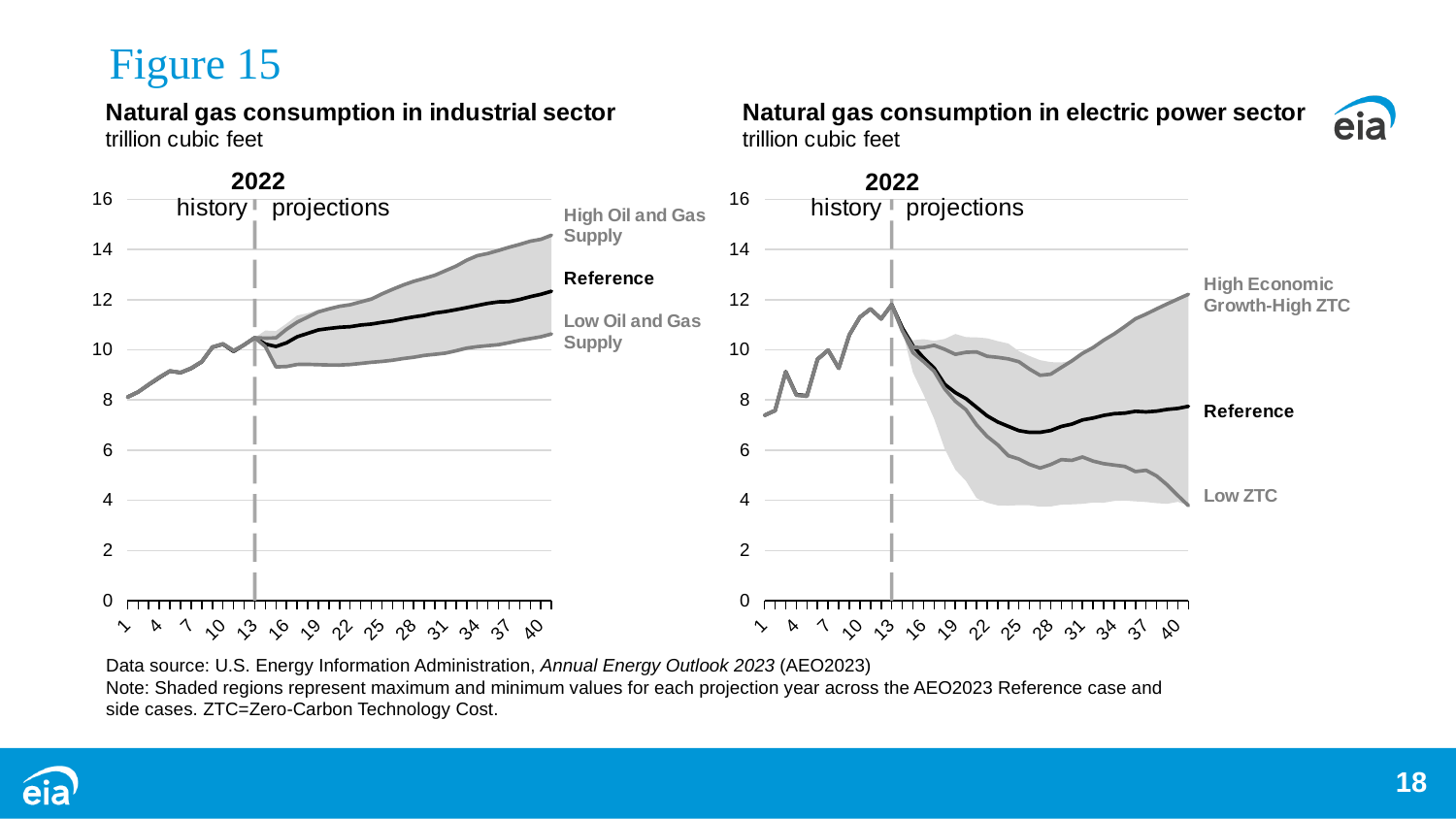
In the 'Natural gas consumption in industrial sector' chart, is the value of the Low Oil and Gas Supply line at the end of the projection period greater or less than 12? less What kind of chart is the 'Natural gas consumption in industrial sector' chart? line chart In the 'Natural gas consumption in electric power sector' chart, which line is higher at the end of the projection period: High Economic Growth-High ZTC or Low ZTC? High Economic Growth-High ZTC In the 'Natural gas consumption in electric power sector' chart, is the value of the Low ZTC line at the end of the projection period greater or less than 6? less How many labeled lines are shown in the 'Natural gas consumption in industrial sector' chart? 3 In the 'Natural gas consumption in industrial sector' chart, is the value of the High Oil and Gas Supply line at the end of the projection period greater or less than 12? greater How many labeled lines are shown in the 'Natural gas consumption in electric power sector' chart? 3 In the 'Natural gas consumption in industrial sector' chart, what unit is shown under the title? trillion cubic feet In the 'Natural gas consumption in electric power sector' chart, which year does the dashed vertical line separating history from projections mark? 2022 In the 'Natural gas consumption in industrial sector' chart, does the Reference line rise or fall over the projection period? rise In the 'Natural gas consumption in electric power sector' chart, does the Low ZTC line rise or fall over the projection period? fall